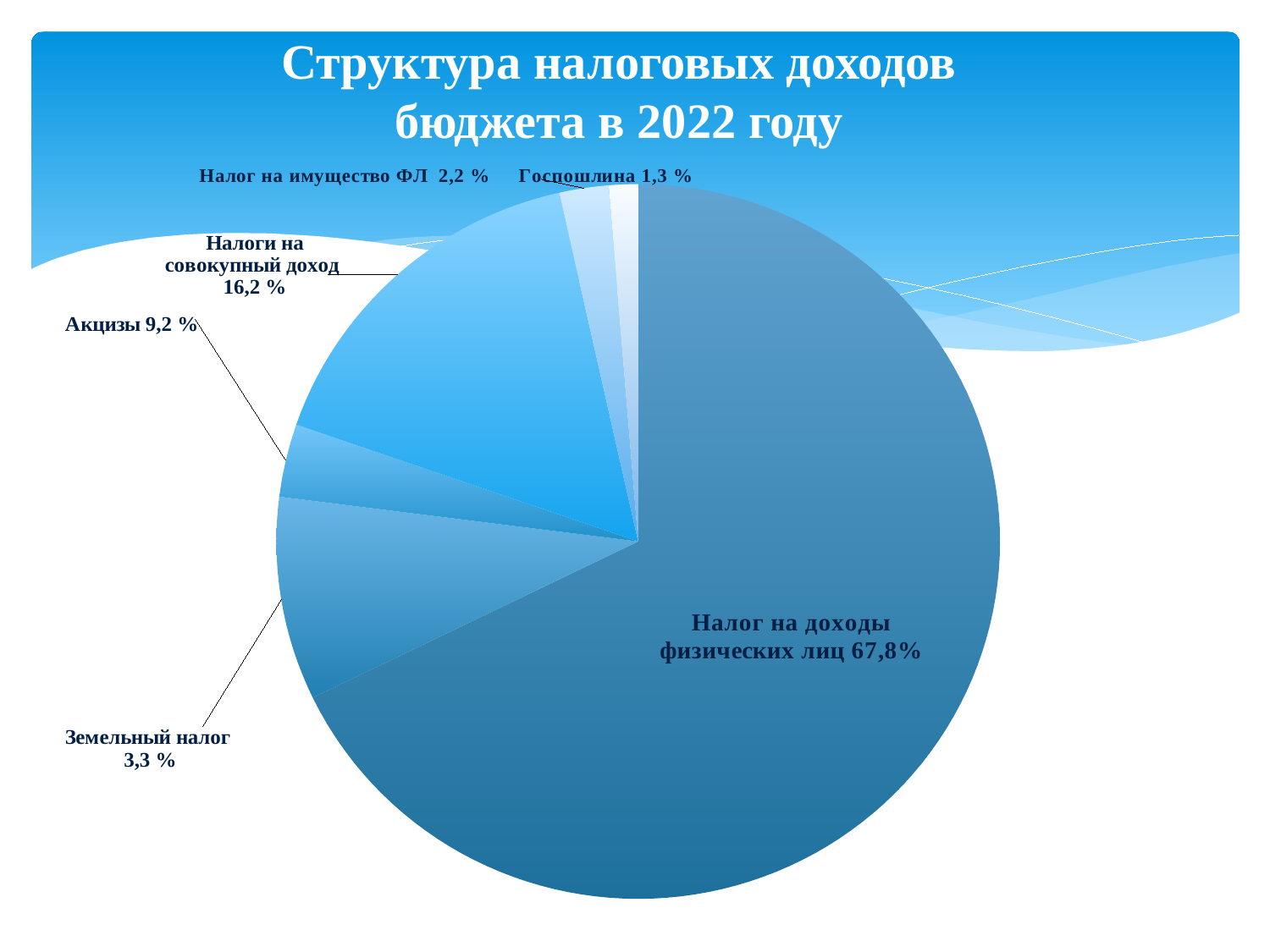
Какая категория имеет наименьшую долю на диаграмме? Госпошлина Какова доля налога на доходы физических лиц на диаграмме? 67,8% На сколько процентных пунктов доля налогов на совокупный доход больше доли акцизов? 7,0 Какова доля налогов на совокупный доход? 16,2 % Какова доля госпошлины? 1,3 % Сколько секторов на круговой диаграмме? 6 Какая категория имеет наибольшую долю на диаграмме? Налог на доходы физических лиц Какова доля земельного налога? 3,3 % Какой тип диаграммы показан на слайде? круговая диаграмма Какова доля акцизов? 9,2 % Что больше: доля земельного налога или доля налога на имущество ФЛ? Земельный налог Как называется диаграмма на слайде? Структура налоговых доходов бюджета в 2022 году